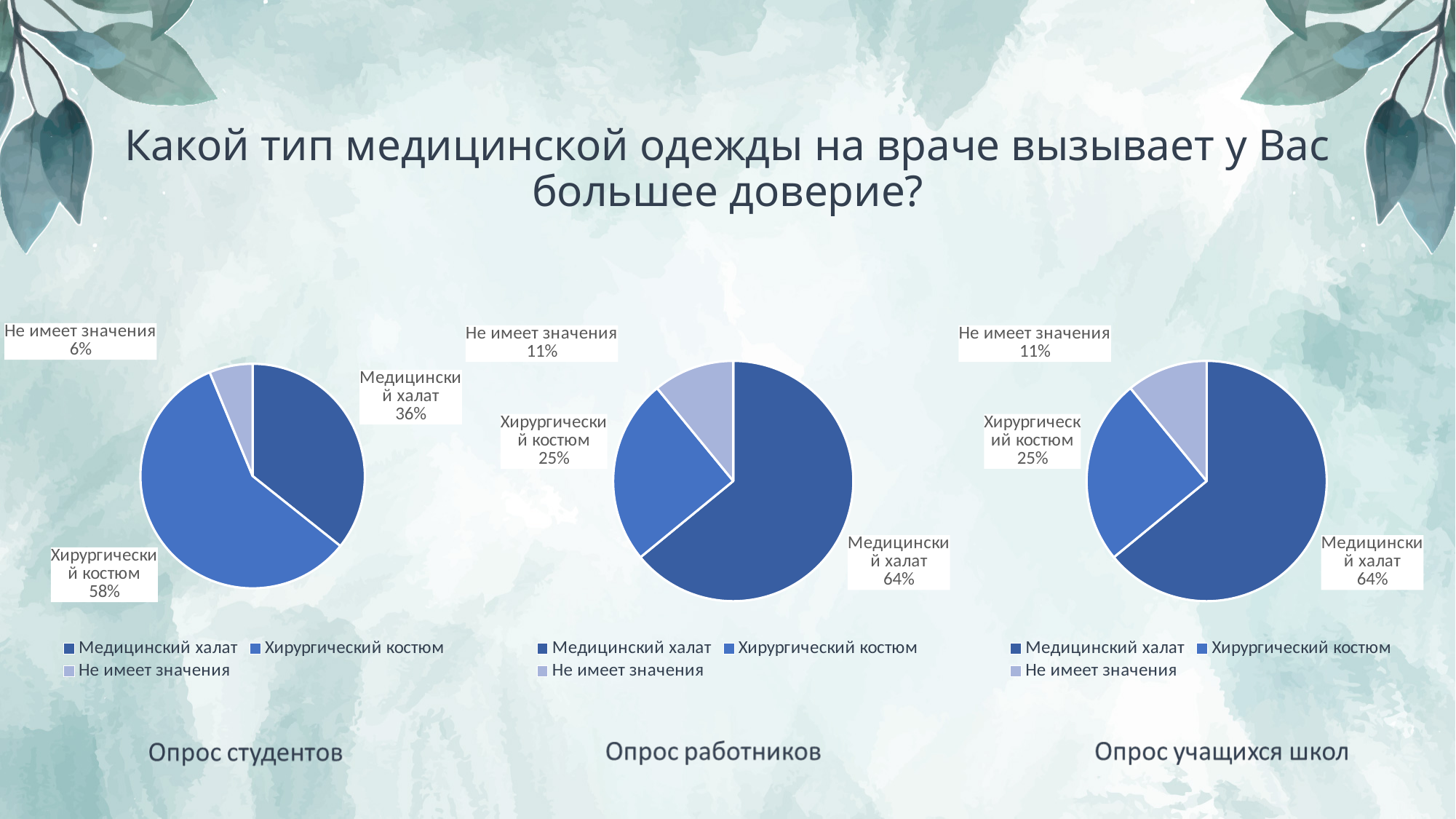
На диаграмме «Опрос студентов» какая доля приходится на «Медицинский халат»? 36% На диаграмме «Опрос учащихся школ» какая доля приходится на «Хирургический костюм»? 25% На диаграмме «Опрос работников» какая категория имеет наименьшую долю? Не имеет значения На диаграмме «Опрос учащихся школ» какая категория имеет наибольшую долю? Медицинский халат На диаграмме «Опрос работников» какая доля приходится на «Не имеет значения»? 11% Какой тип диаграммы используется на слайде «Опрос работников»? Круговая диаграмма На диаграмме «Опрос работников» что больше: доля «Медицинский халат» или доля «Хирургический костюм»? Медицинский халат На диаграмме «Опрос студентов» какая категория имеет наибольшую долю? Хирургический костюм На диаграмме «Опрос студентов» на сколько процентных пунктов доля «Хирургический костюм» больше доли «Медицинский халат»? 22 Сколько категорий показано на диаграмме «Опрос учащихся школ»? 3 На диаграмме «Опрос студентов» какая доля приходится на «Хирургический костюм»? 58% Сколько диаграмм показано на слайде? 3